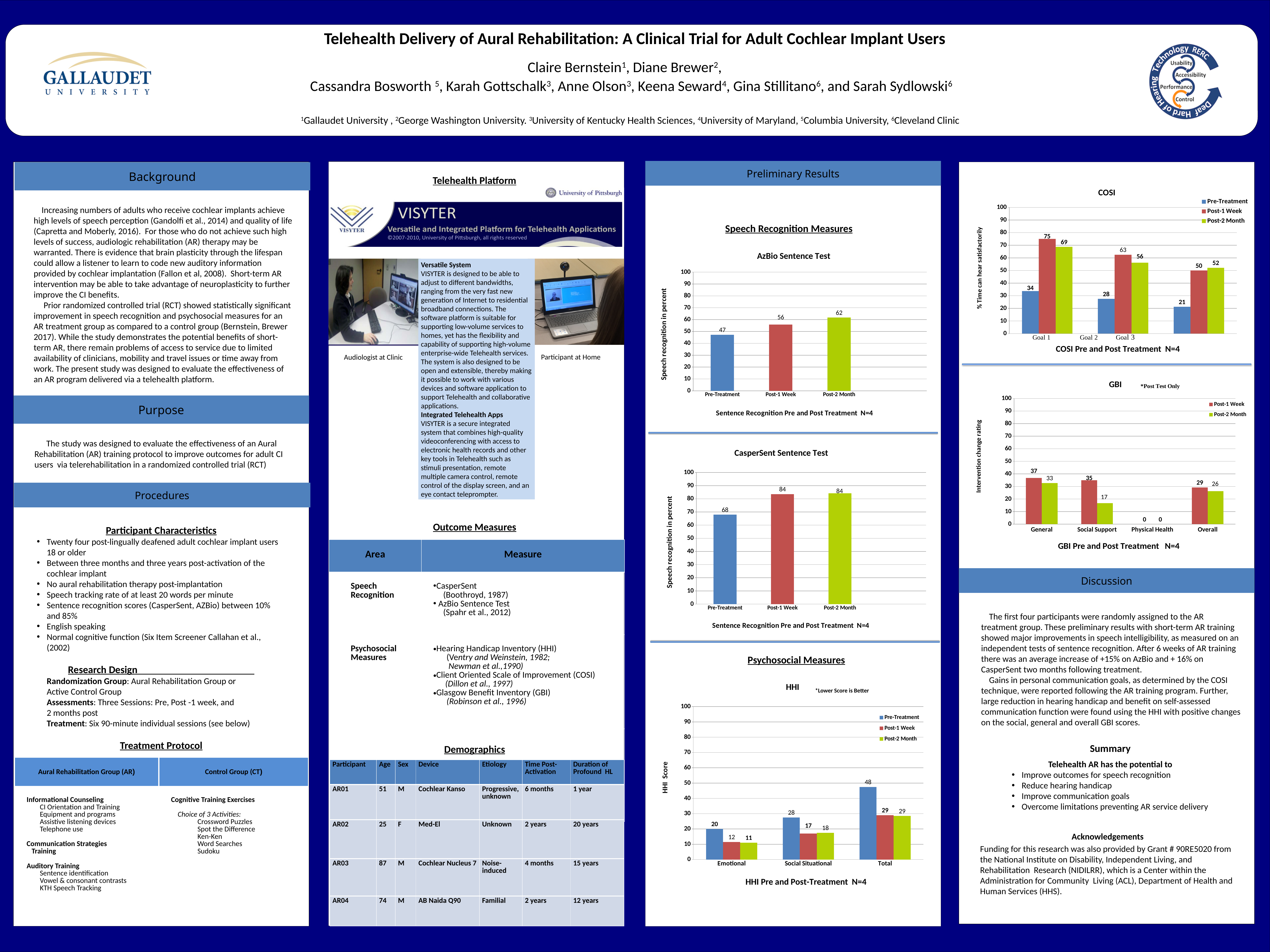
In the AzBio Sentence Test chart, what is the speech recognition value at Post-2 Month? 62 In the GBI chart, what is the Post-1 Week value for Social Support? 35 In the COSI chart, what is the Post-1 Week value for Goal 1? 75 In the HHI chart, what is the Pre-Treatment value for Total? 48 What kind of chart is the GBI chart? bar chart In the COSI chart, which is larger for Goal 3: Post-1 Week or Post-2 Month? Post-2 Month In the HHI chart, which category has the lowest Post-2 Month value? Emotional In the CasperSent Sentence Test chart, what is the Pre-Treatment value? 68 In the CasperSent Sentence Test chart, how many categories are shown on the x axis? 3 In the HHI chart, how many series does the legend list? 3 In the AzBio Sentence Test chart, what is the difference between the Post-2 Month and Pre-Treatment values? 15 In the AzBio Sentence Test chart, do the values rise or fall from Pre-Treatment to Post-2 Month? rise